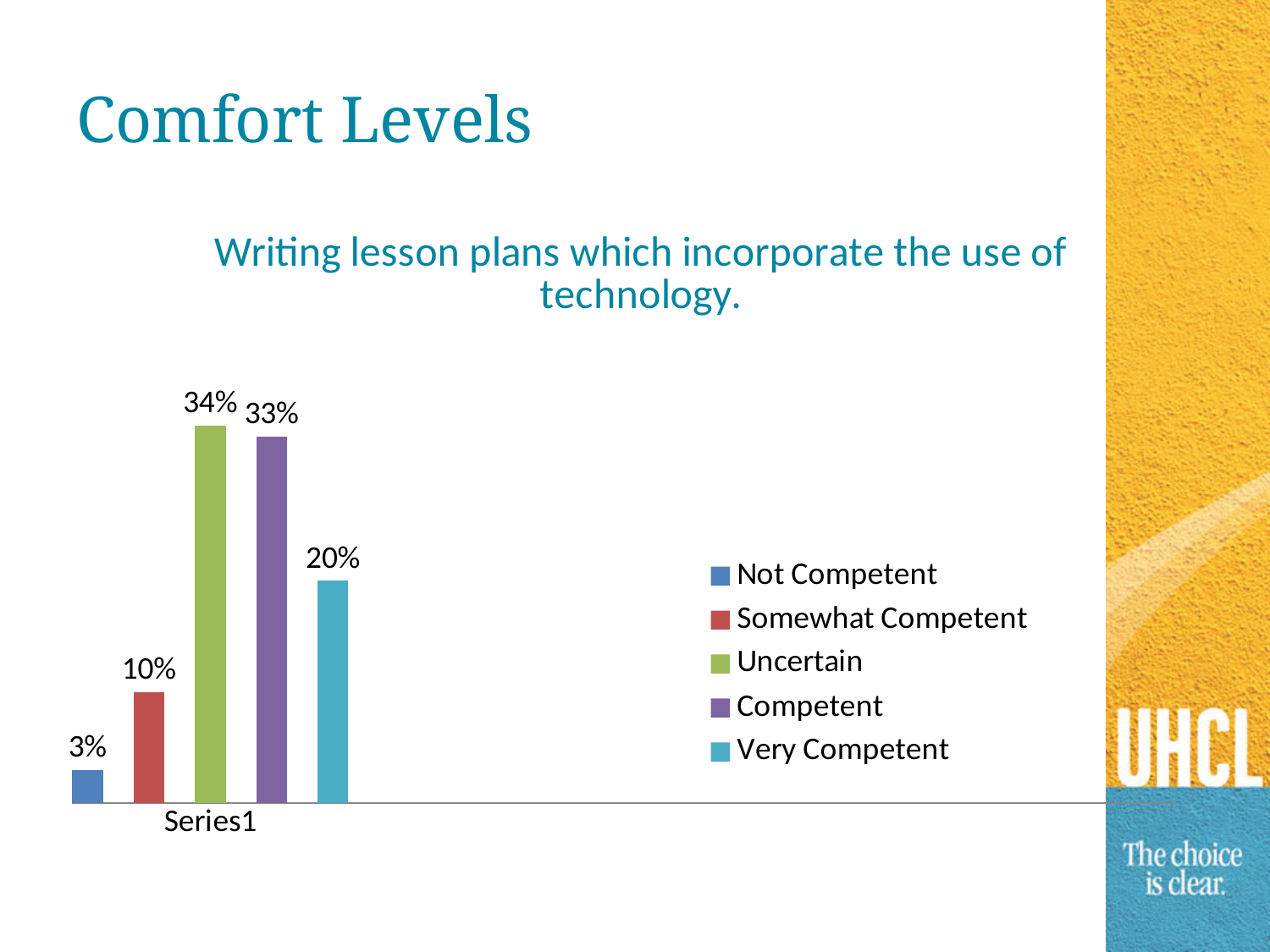
How many series does the legend list? 5 What is the value for Very Competent? 20% What is the value for Not Competent? 3% What is the difference between the Somewhat Competent and Not Competent values? 7% What is the title of the chart? Writing lesson plans which incorporate the use of technology. What is the value for Somewhat Competent? 10% Which is larger, the value for Very Competent or the value for Somewhat Competent? Very Competent What colour is the bar for Uncertain? Green What percentage of respondents reported being Uncertain? 34% What kind of chart is shown on the slide? Bar chart Which comfort level has the lowest value? Not Competent What is the difference between the Competent and Very Competent values? 13%